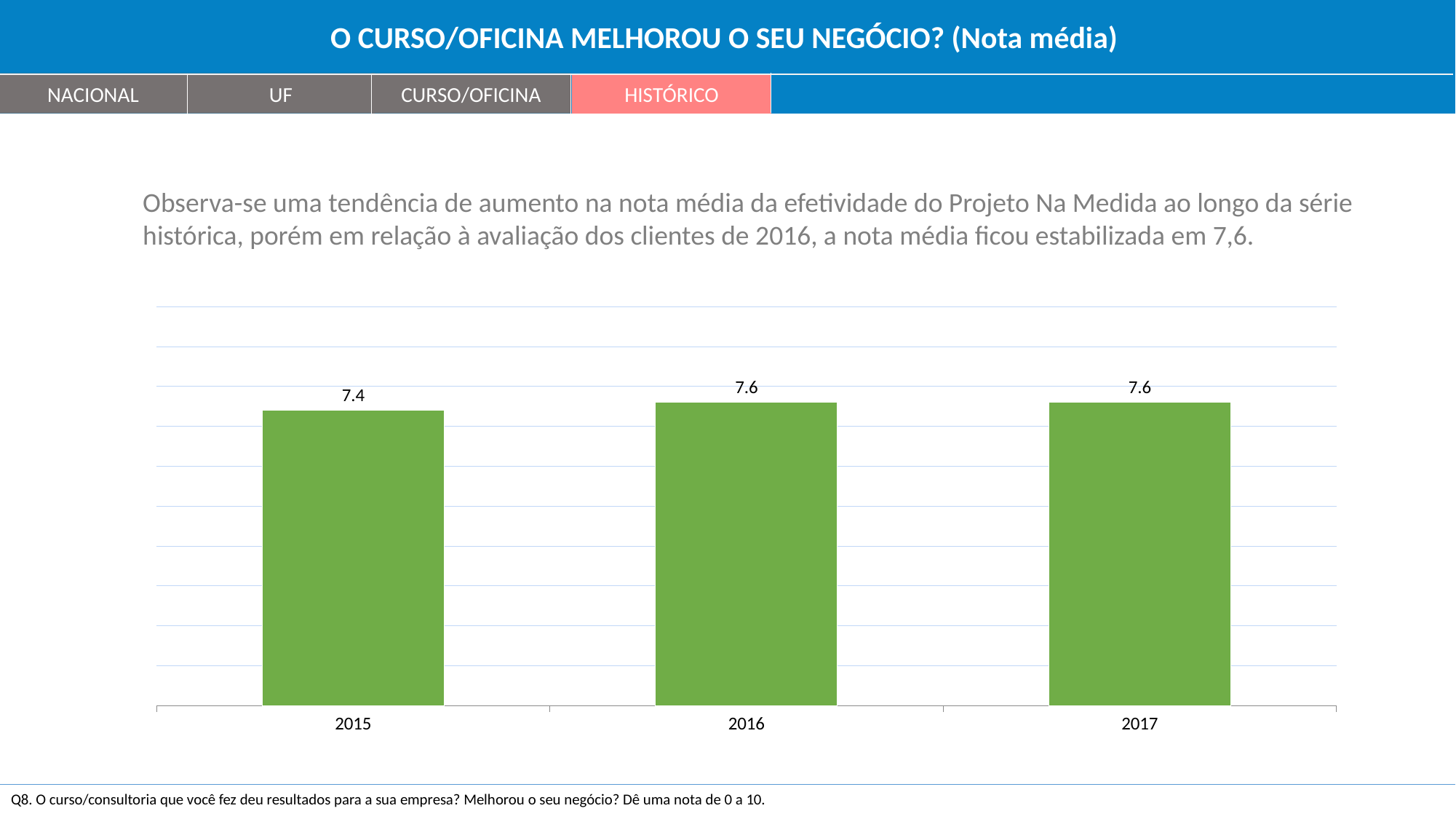
Which is larger, the value for 2015 or the value for 2017? 2017 Do the values rise or fall from 2015 to 2016? rise What is the title of the slide? O CURSO/OFICINA MELHOROU O SEU NEGÓCIO? (Nota média) Which year has the lowest value? 2015 What is the difference between the values for 2016 and 2015? 0.2 What kind of chart is shown on the slide? bar chart What is the value for 2016? 7.6 How many years are shown on the x axis? 3 What is the value for 2017? 7.6 Do the values change between 2016 and 2017? No, both are 7.6 What colour are the bars in the chart? green What is the value for 2015? 7.4